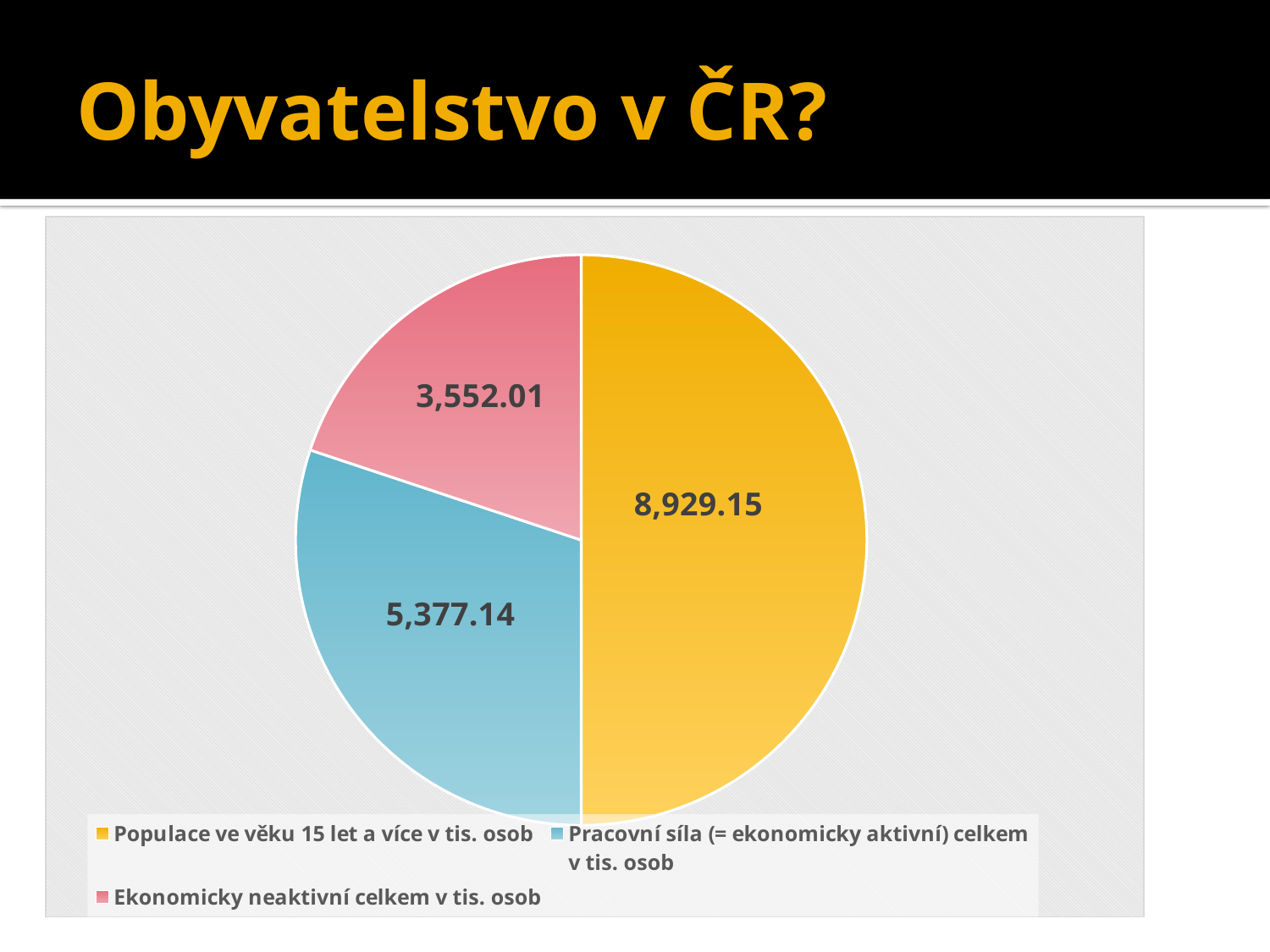
What colour is the slice for 'Ekonomicky neaktivní celkem v tis. osob'? pink What is the value for 'Populace ve věku 15 let a více v tis. osob'? 8,929.15 What is the value for 'Pracovní síla (= ekonomicky aktivní) celkem v tis. osob'? 5,377.14 Which category has the largest slice of the pie? Populace ve věku 15 let a více v tis. osob What type of chart is shown on the slide? pie chart What is the difference between the value for 'Populace ve věku 15 let a více' and the value for 'Pracovní síla (= ekonomicky aktivní) celkem'? 3,552.01 Which is larger: the value for 'Pracovní síla (= ekonomicky aktivní) celkem' or the value for 'Ekonomicky neaktivní celkem'? Pracovní síla (= ekonomicky aktivní) celkem What is the value for 'Ekonomicky neaktivní celkem v tis. osob'? 3,552.01 How many slices does the pie chart have? 3 What is the difference between the value for 'Pracovní síla (= ekonomicky aktivní) celkem' and the value for 'Ekonomicky neaktivní celkem'? 1,825.13 Which category has the smallest slice of the pie? Ekonomicky neaktivní celkem v tis. osob What share of the pie does the 'Populace ve věku 15 let a více' slice represent? 50%